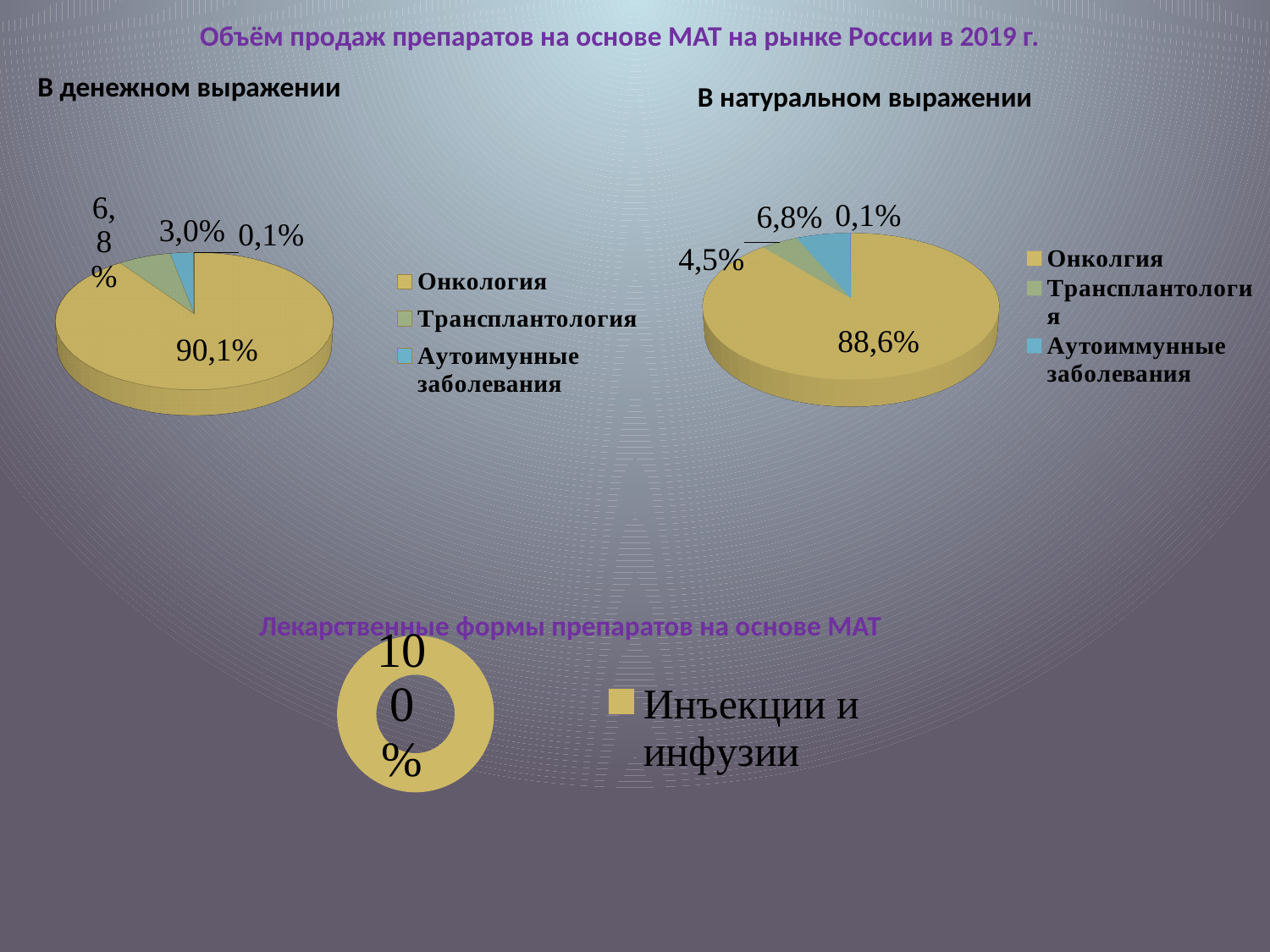
What is the title of the chart at the bottom of the slide? Лекарственные формы препаратов на основе МАТ In the 'В денежном выражении' chart, what share does Трансплантология have? 6,8% What kind of chart is the 'В денежном выражении' chart? Pie chart In the 'В денежном выражении' chart, which is larger: Трансплантология or Аутоимунные заболевания? Трансплантология In the 'В денежном выражении' chart, what share do Аутоимунные заболевания have? 3,0% By how many percentage points does the oncology share in the 'В денежном выражении' chart exceed the oncology share in the 'В натуральном выражении' chart? 1,5 How many entries does the legend of the 'В натуральном выражении' chart list? 3 In the 'В натуральном выражении' chart, what share does Онколгия have? 88,6% In the 'В денежном выражении' chart, what share does Онкология have? 90,1% What kind of chart is the 'Лекарственные формы препаратов на основе МАТ' chart? Doughnut chart In the 'Лекарственные формы препаратов на основе МАТ' chart, what share do Инъекции и инфузии have? 100% In the 'В натуральном выражении' chart, which category has the largest share? Онколгия